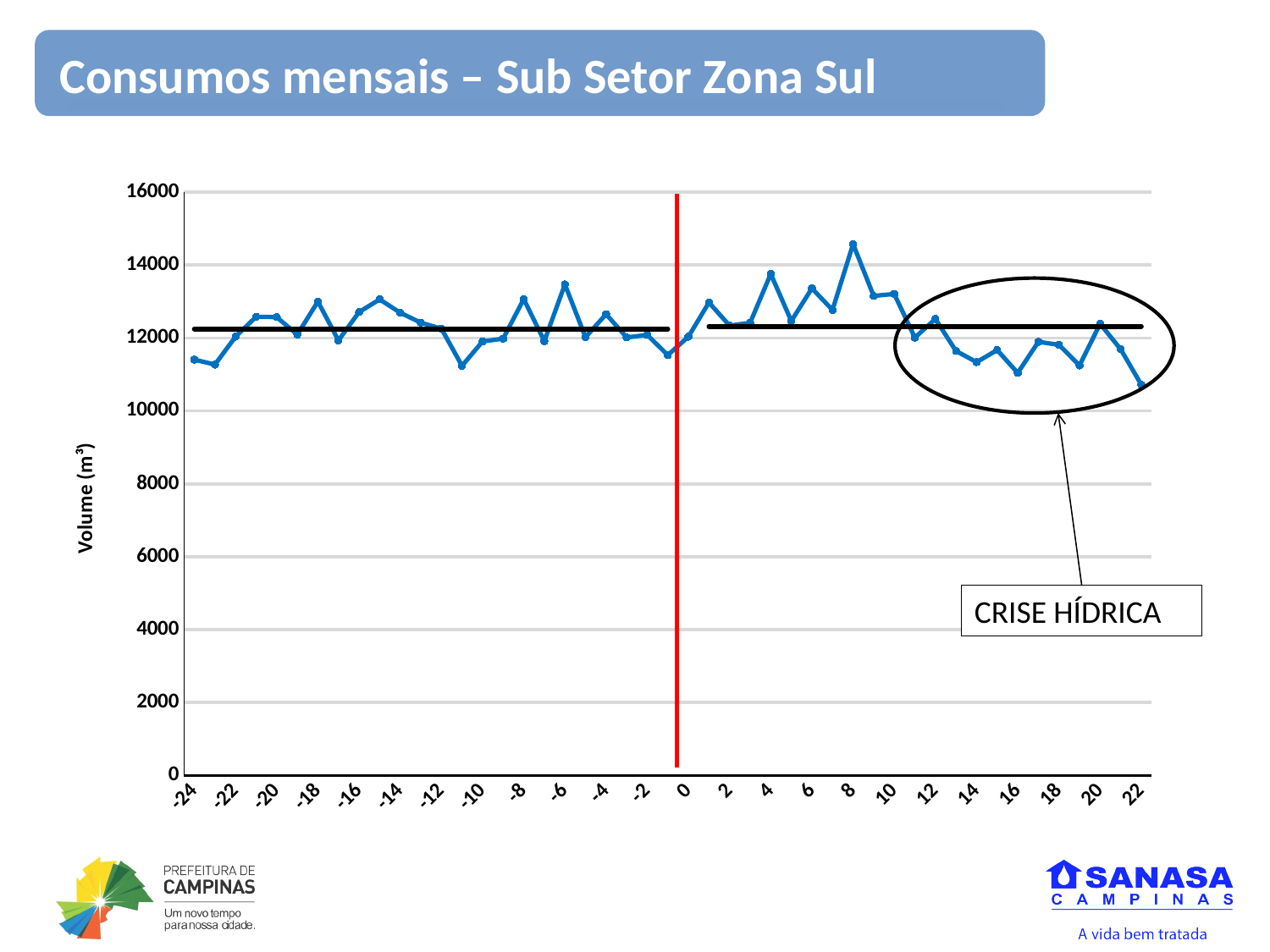
Is the value at x = 22 greater or less than 12000? less Is the value at x = 14 greater or less than 12000? less What is the title of the slide's chart? Consumos mensais – Sub Setor Zona Sul Which is larger, the value at x = 8 or the value at x = 22? x = 8 Do the values generally rise or fall from x = 10 to x = 22? fall What is the highest tick value shown on the y axis? 16000 Is the value at x = 8 greater or less than 14000? greater What kind of chart is shown on the slide? line chart What is the label of the y axis? Volume (m³) At which x-axis value does the line reach its highest point? 8